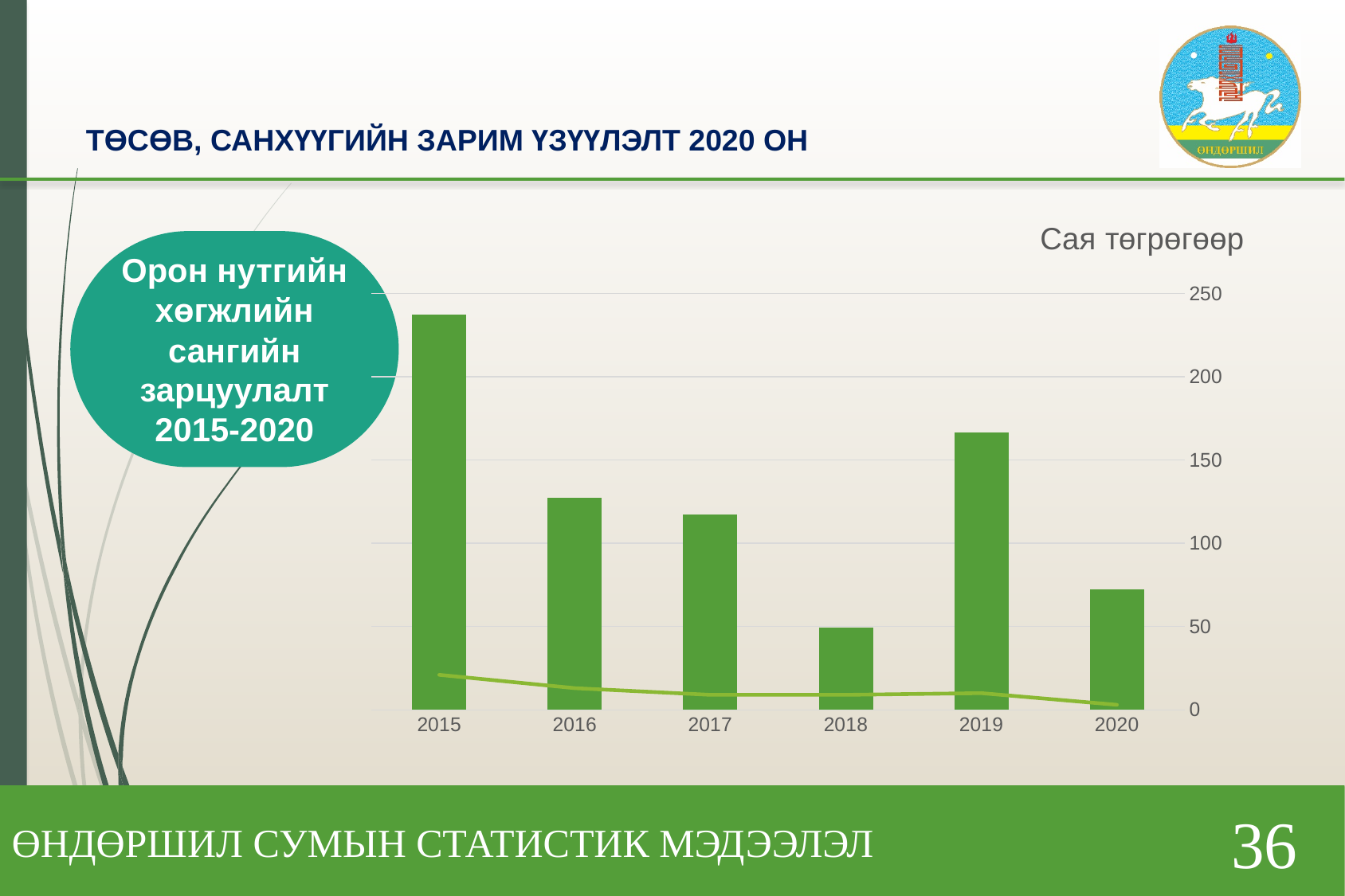
Which bar is taller, 2019 or 2016? 2019 Which year has the tallest bar in the chart? 2015 Which year has the shortest bar in the chart? 2018 Which bar is taller, 2020 or 2017? 2017 How many years are shown on the x axis of the chart? 6 Is the value for 2016 greater or less than 100? greater What unit label is shown above the chart? Сая төгрөгөөр Is the value for 2019 greater or less than 150? greater Is the value for 2020 greater or less than 100? less What kind of chart is shown on the slide? combination bar and line chart Does the line plotted along the bottom of the chart rise or fall from 2015 to 2020? fall